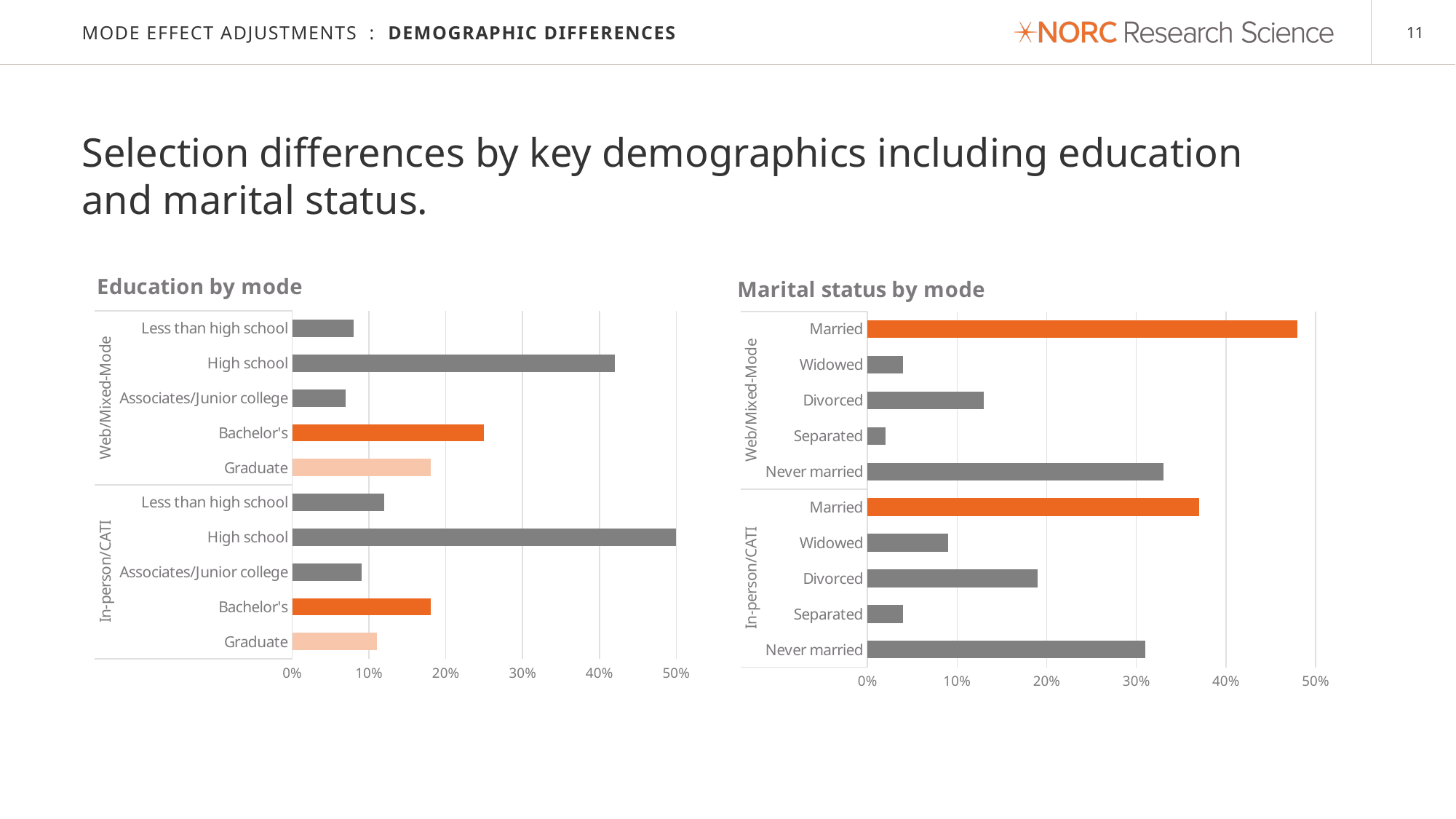
In the "Marital status by mode" chart, is the value for Married under Web/Mixed-Mode greater or less than 40%? greater In the "Education by mode" chart, which education category has the longest bar for Web/Mixed-Mode? High school In the "Education by mode" chart, which is larger for Bachelor's: Web/Mixed-Mode or In-person/CATI? Web/Mixed-Mode In the "Marital status by mode" chart, which is larger for Married: Web/Mixed-Mode or In-person/CATI? Web/Mixed-Mode In the "Marital status by mode" chart, which marital status has the shortest bar for In-person/CATI? Separated In the "Education by mode" chart, how many education categories are shown for each mode? 5 In the "Education by mode" chart, is the value for Bachelor's under Web/Mixed-Mode greater or less than 20%? greater What kind of chart is the "Education by mode" chart? bar chart In the "Education by mode" chart, which education category is shown with a dark orange bar? Bachelor's In the "Marital status by mode" chart, is the value for Divorced under In-person/CATI greater or less than 10%? greater In the "Marital status by mode" chart, which marital status has the longest bar for Web/Mixed-Mode? Married